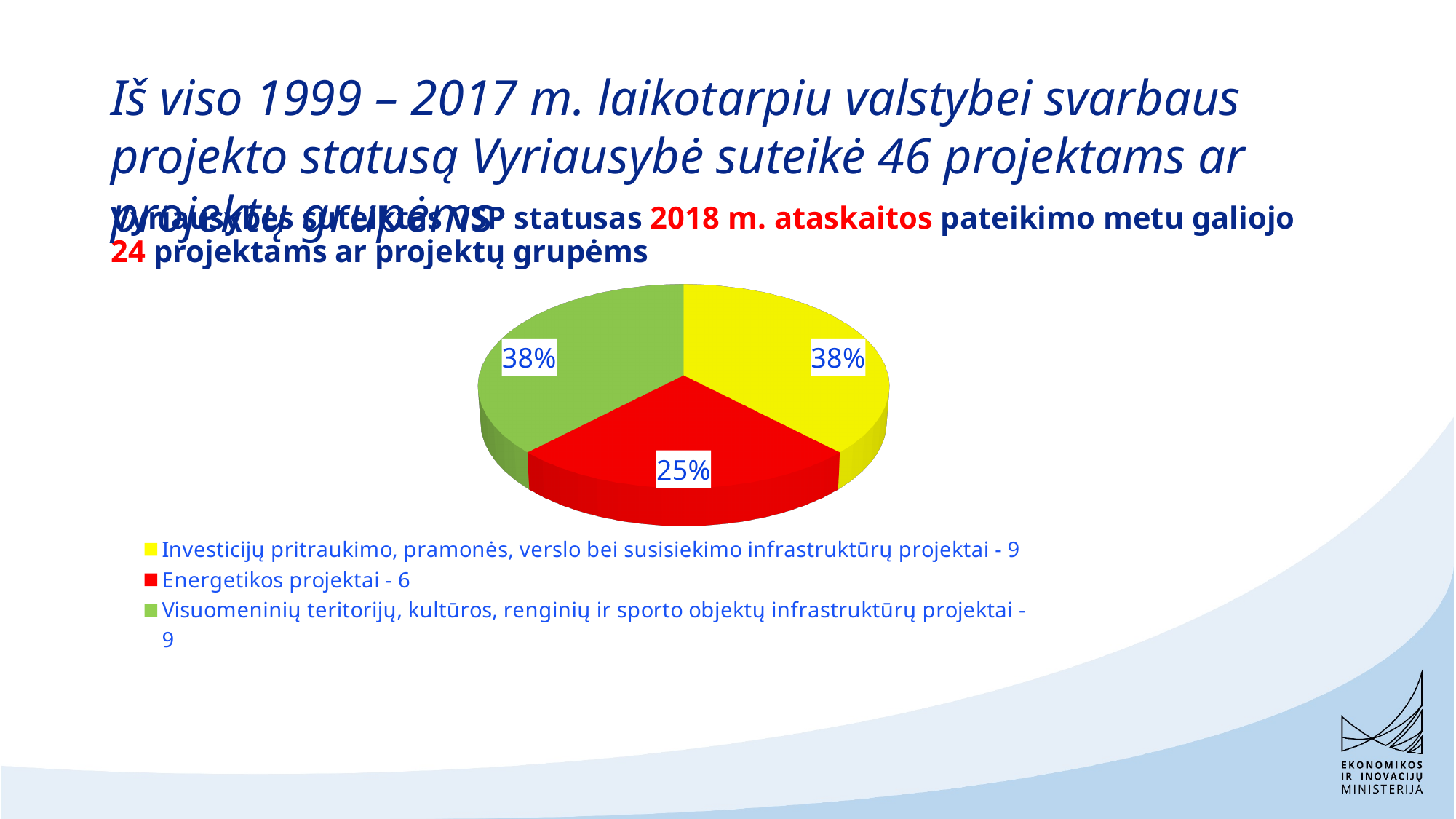
What share of the pie does "Energetikos projektai" represent? 25% What kind of chart is shown on the slide? pie chart How many slices does the pie chart have? 3 What colour is the slice for "Energetikos projektai"? red How many entries does the legend list? 3 What share of the pie does "Visuomeninių teritorijų, kultūros, renginių ir sporto objektų infrastruktūrų projektai" represent? 38% What share of the pie does "Investicijų pritraukimo, pramonės, verslo bei susisiekimo infrastruktūrų projektai" represent? 38% How many projects does the legend list for "Investicijų pritraukimo, pramonės, verslo bei susisiekimo infrastruktūrų projektai"? 9 Which slice is larger: the yellow slice or the red slice? the yellow slice Which category has the smallest slice of the pie? Energetikos projektai How many projects does the legend list for "Energetikos projektai"? 6 What is the difference in percentage points between the green slice (38%) and the red slice (25%)? 13